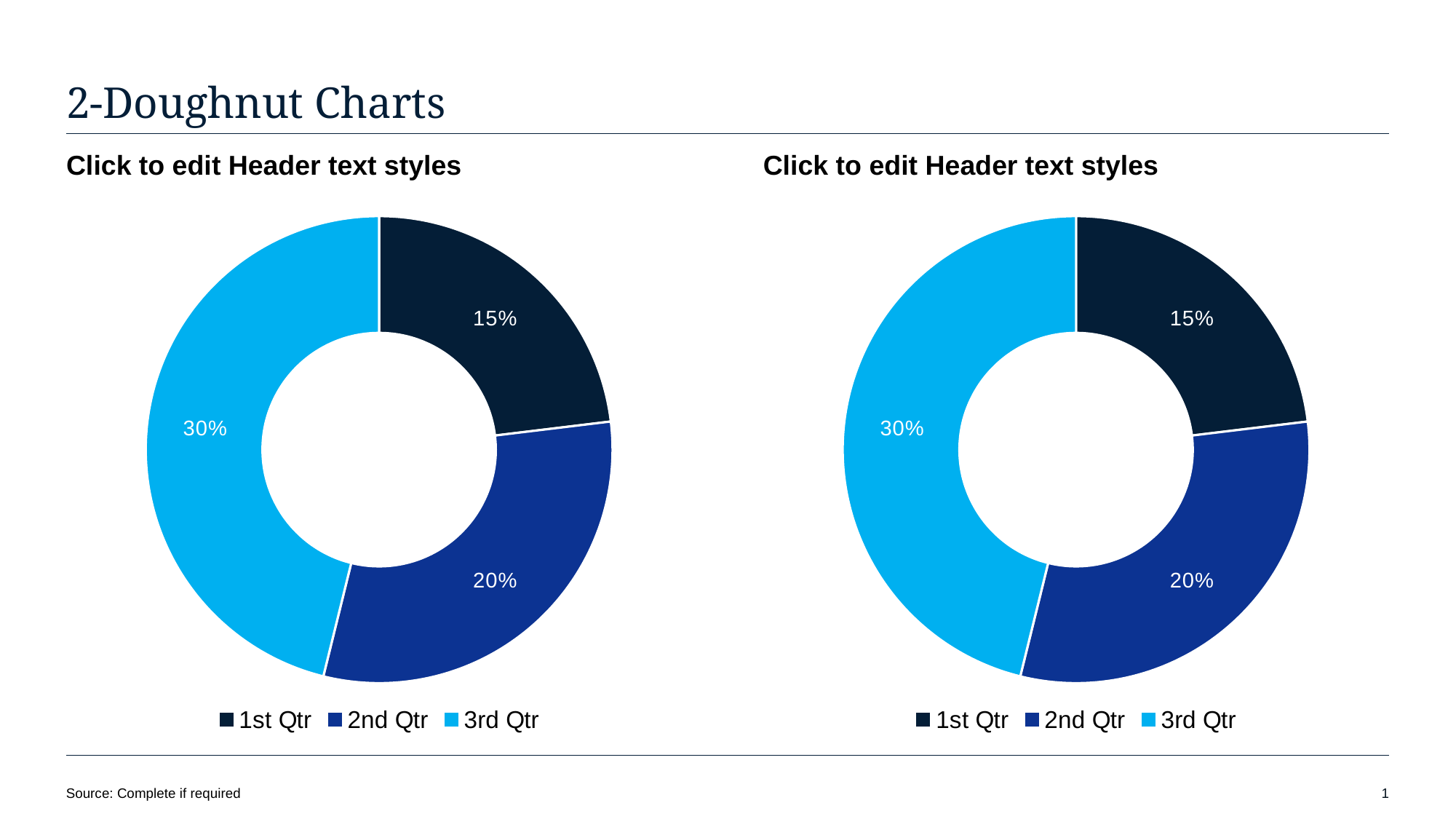
What type of chart is shown on the left of the slide? Doughnut chart In the left doughnut chart, what is the value shown for 1st Qtr? 15% In the right doughnut chart, what is the value shown for 2nd Qtr? 20% In the right doughnut chart, what is the value shown for 3rd Qtr? 30% In the right doughnut chart, what is the difference between the 2nd Qtr and 1st Qtr values? 5% In the right doughnut chart, which quarter has the smallest slice? 1st Qtr In the right doughnut chart, which is larger, 2nd Qtr or 3rd Qtr? 3rd Qtr In the left doughnut chart, what is the value shown for 2nd Qtr? 20% How many entries does the legend of the right doughnut chart list? 3 How many slices does the left doughnut chart have? 3 In the left doughnut chart, which quarter has the largest slice? 3rd Qtr In the left doughnut chart, what is the difference between the 3rd Qtr and 1st Qtr values? 15%